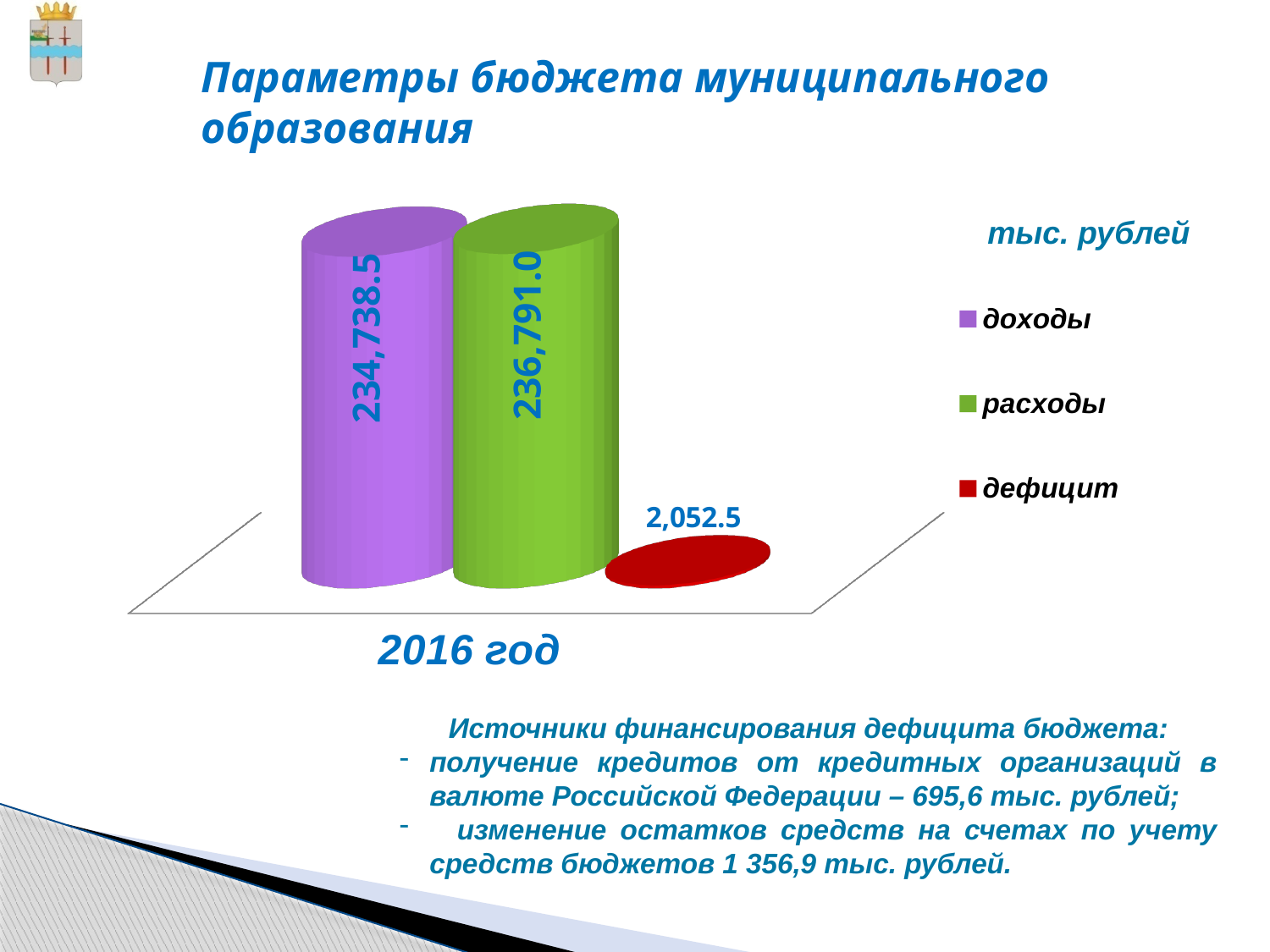
How many categories are shown on the x axis? 1 What is the value for дефицит in 2016 год? 2,052.5 Which series has the highest value in 2016 год? расходы What kind of chart is shown on the slide? bar chart What is the value for доходы in 2016 год? 234,738.5 What unit is indicated for the chart values? тыс. рублей What is the difference between доходы and дефицит in 2016 год? 232,686.0 What is the value for расходы in 2016 год? 236,791.0 What is the difference between расходы and доходы in 2016 год? 2,052.5 How many series does the legend list? 3 Which series has the lowest value in 2016 год? дефицит Which is larger in 2016 год, доходы or расходы? расходы